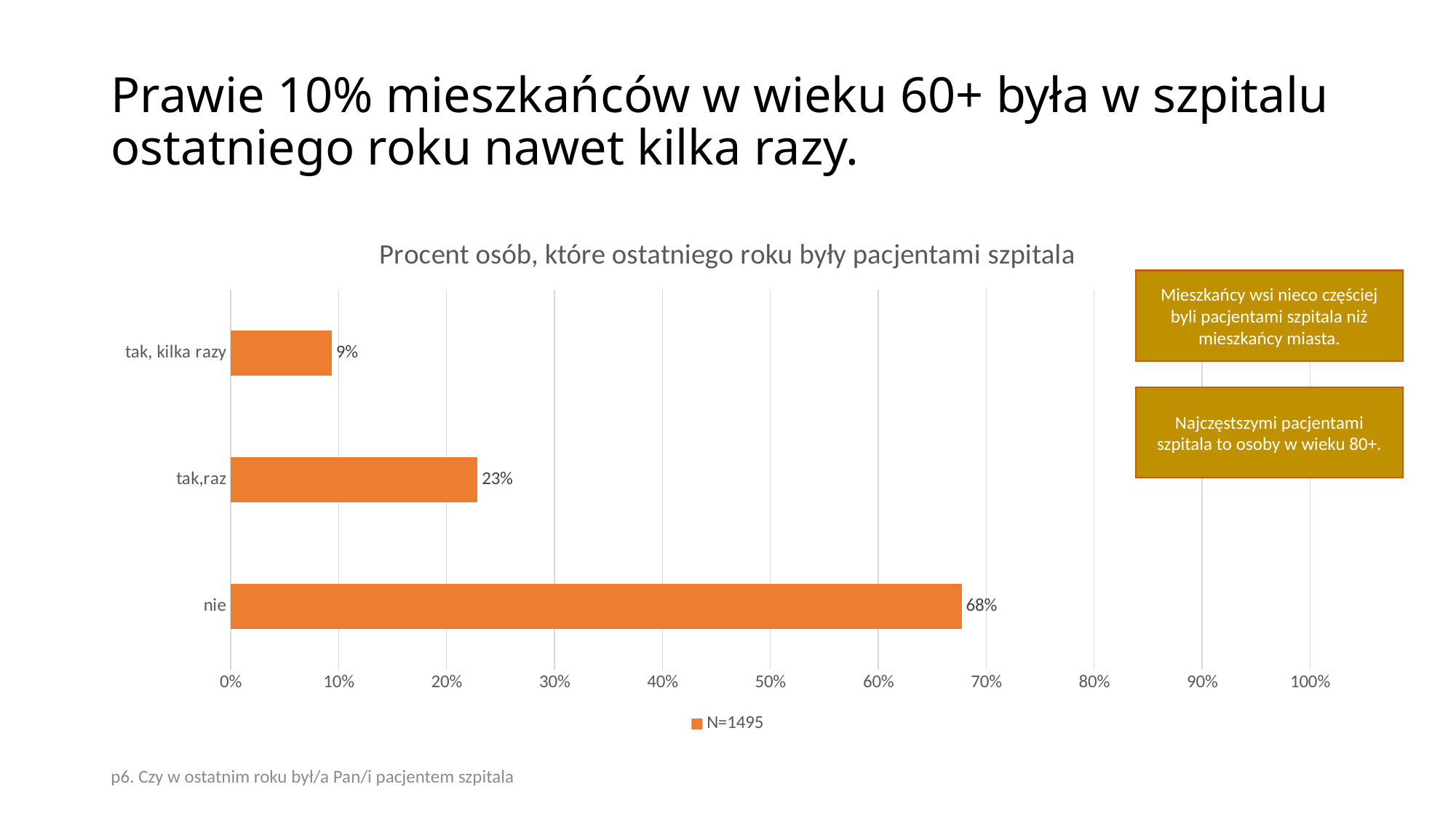
What kind of chart is shown on the slide? bar chart What is the difference between the values for "tak,raz" and "tak, kilka razy"? 14% What is the value for "nie"? 68% What is the difference between the values for "nie" and "tak,raz"? 45% What is the legend entry of the chart? N=1495 Which category has the highest value? nie Is the value for "nie" greater or less than 60%? greater What is the value for "tak,raz"? 23% Which is larger, the value for "tak,raz" or the value for "tak, kilka razy"? tak,raz How many categories are shown in the chart? 3 What is the value for "tak, kilka razy"? 9% Which category has the lowest value? tak, kilka razy